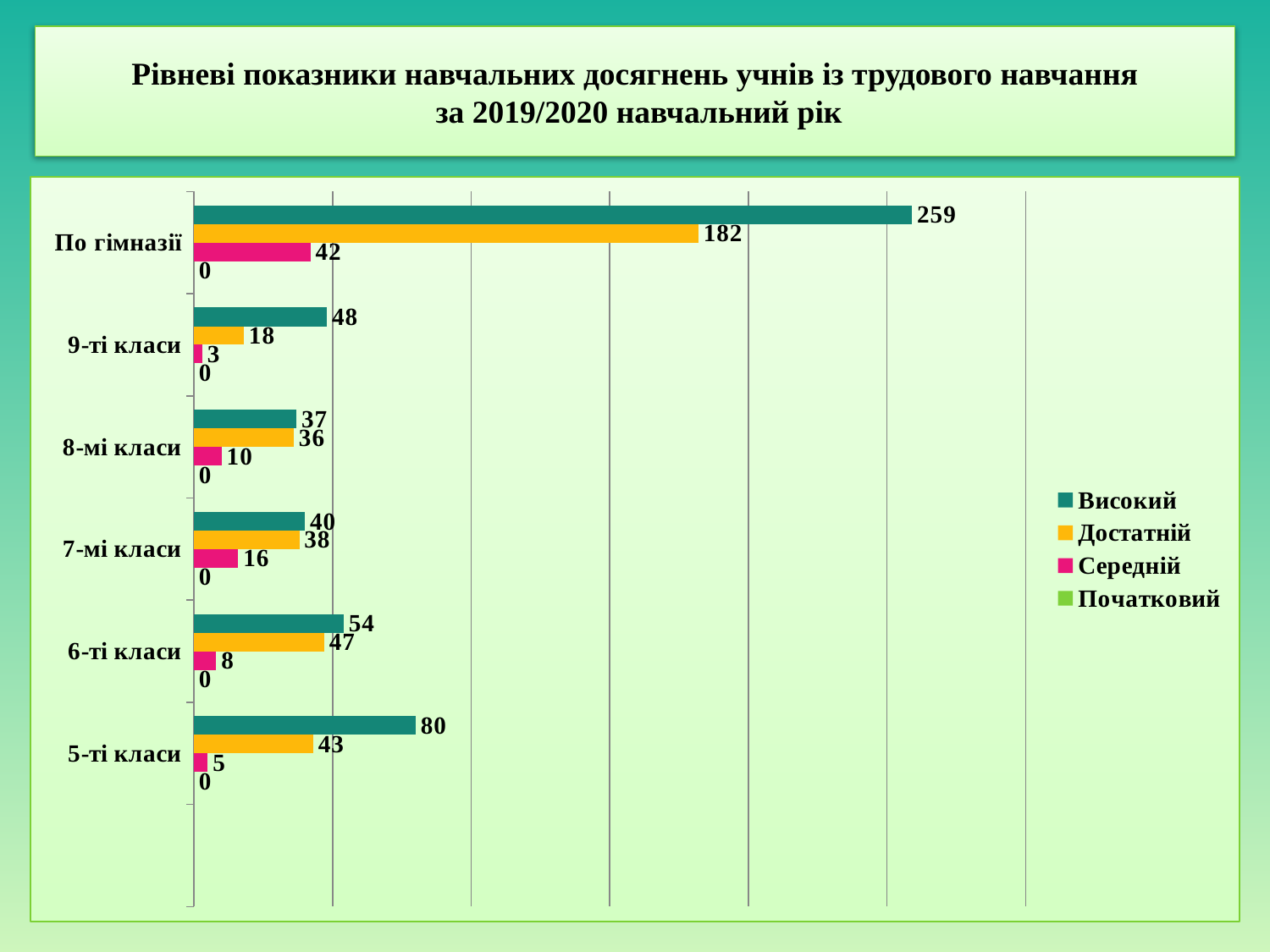
What is the value of Початковий for 9-ті класи? 0 How many categories are shown on the chart? 6 Which series is shown in pink on the chart? Середній How many series does the legend list? 4 What is the value of Достатній for По гімназії? 182 What is the difference between the Високий and Достатній values for По гімназії? 77 Which is larger: the Достатній value for 6-ті класи or the Достатній value for 5-ті класи? 6-ті класи Among the class categories (excluding По гімназії), which has the lowest Середній value? 9-ті класи Among the class categories (excluding По гімназії), which has the highest Високий value? 5-ті класи What is the value of Високий for 5-ті класи? 80 What is the value of Середній for 7-мі класи? 16 What kind of chart is shown on the slide? Bar chart